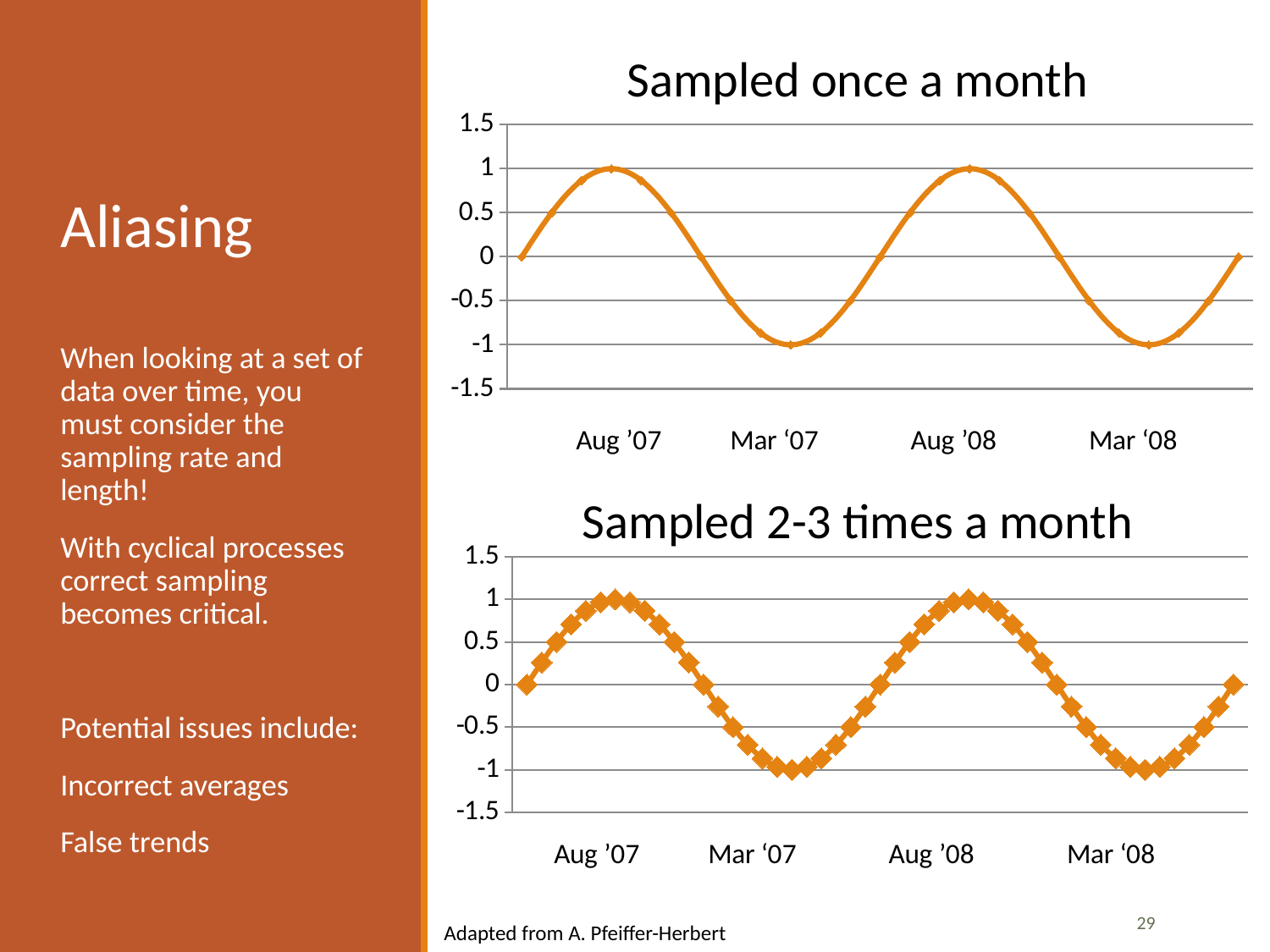
In the 'Sampled once a month' chart, is the value at Aug '07 greater or less than 0.5? greater How many labels are shown on the x axis of the 'Sampled once a month' chart? 4 What is the title of the lower chart on the slide? Sampled 2-3 times a month In the 'Sampled 2-3 times a month' chart, do the values rise or fall between Mar '07 and Aug '08? rise What kind of chart is the 'Sampled once a month' chart? line chart In the 'Sampled 2-3 times a month' chart, is the value at Mar '07 greater or less than -0.5? less In the 'Sampled once a month' chart, what is the highest value the line reaches? 1 In the 'Sampled 2-3 times a month' chart, what is the lowest value the line reaches? -1 What kind of chart is the 'Sampled 2-3 times a month' chart? line chart In the 'Sampled once a month' chart, which is larger, the value at Aug '07 or the value at Mar '07? Aug '07 In the 'Sampled once a month' chart, do the values rise or fall between Aug '07 and Mar '07? fall In the 'Sampled 2-3 times a month' chart, which is larger, the value at Aug '08 or the value at Mar '08? Aug '08